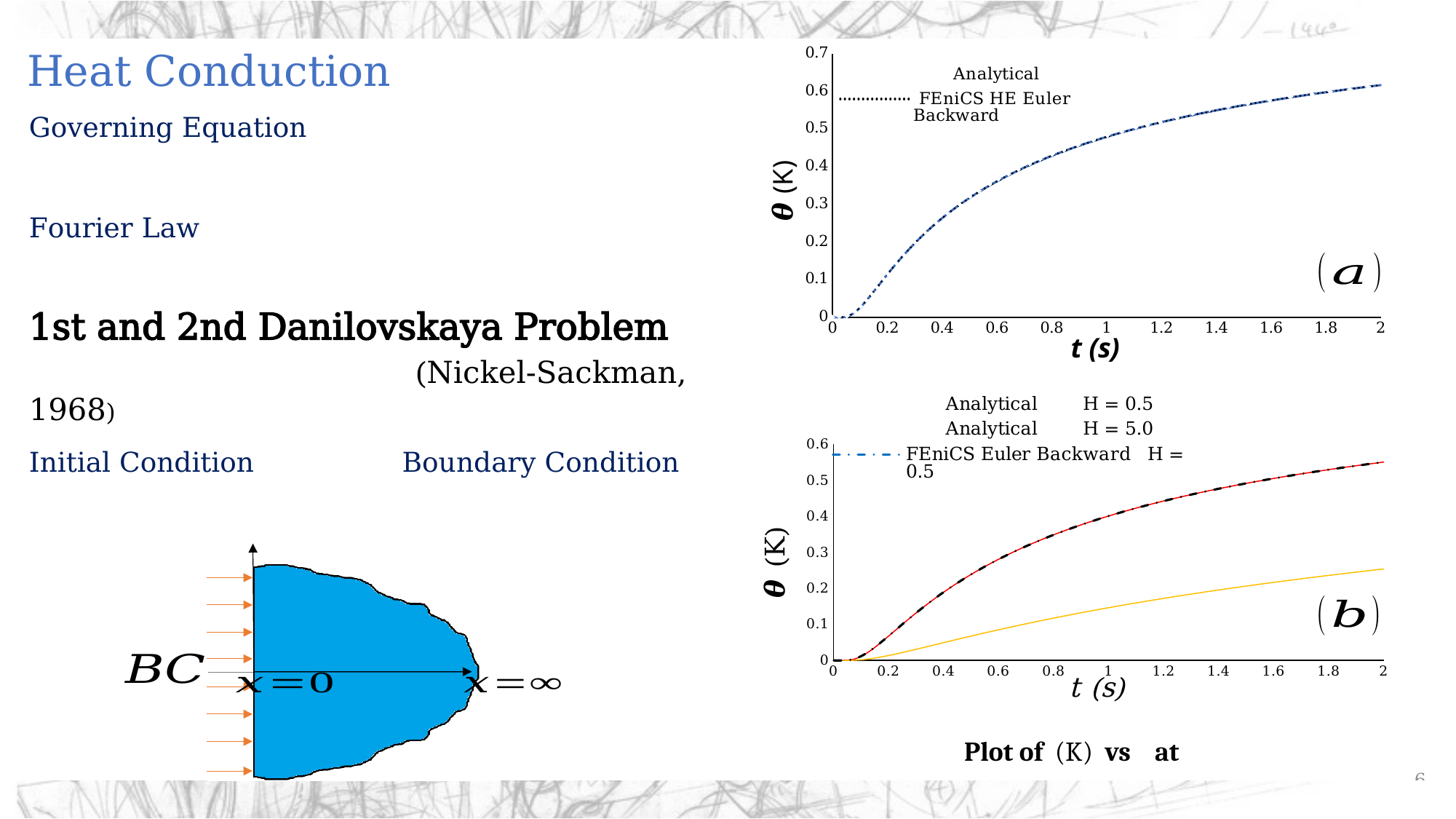
What is the name of the second legend entry in chart (a)? FEniCS HE Euler Backward In chart (b), do the curves rise or fall as t increases? rise How many series does the legend of chart (a) list? 2 In chart (a), is the value at t = 1 greater or less than 0.4? greater In chart (a), does the plotted value rise or fall as t increases from 0 to 2? rises What is the x-axis label of chart (a)? t (s) What kind of chart is chart (a), the upper chart on the right? line chart In chart (a), is the value at t = 0.4 greater or less than 0.3? less In chart (b), is the value of the yellow (lower) curve at t = 2 greater or less than 0.3? less How many series does the legend of chart (b), the lower chart, list? 3 In chart (b), which curve is higher at t = 2, the yellow curve or the red/black dashed curve? the red/black dashed curve